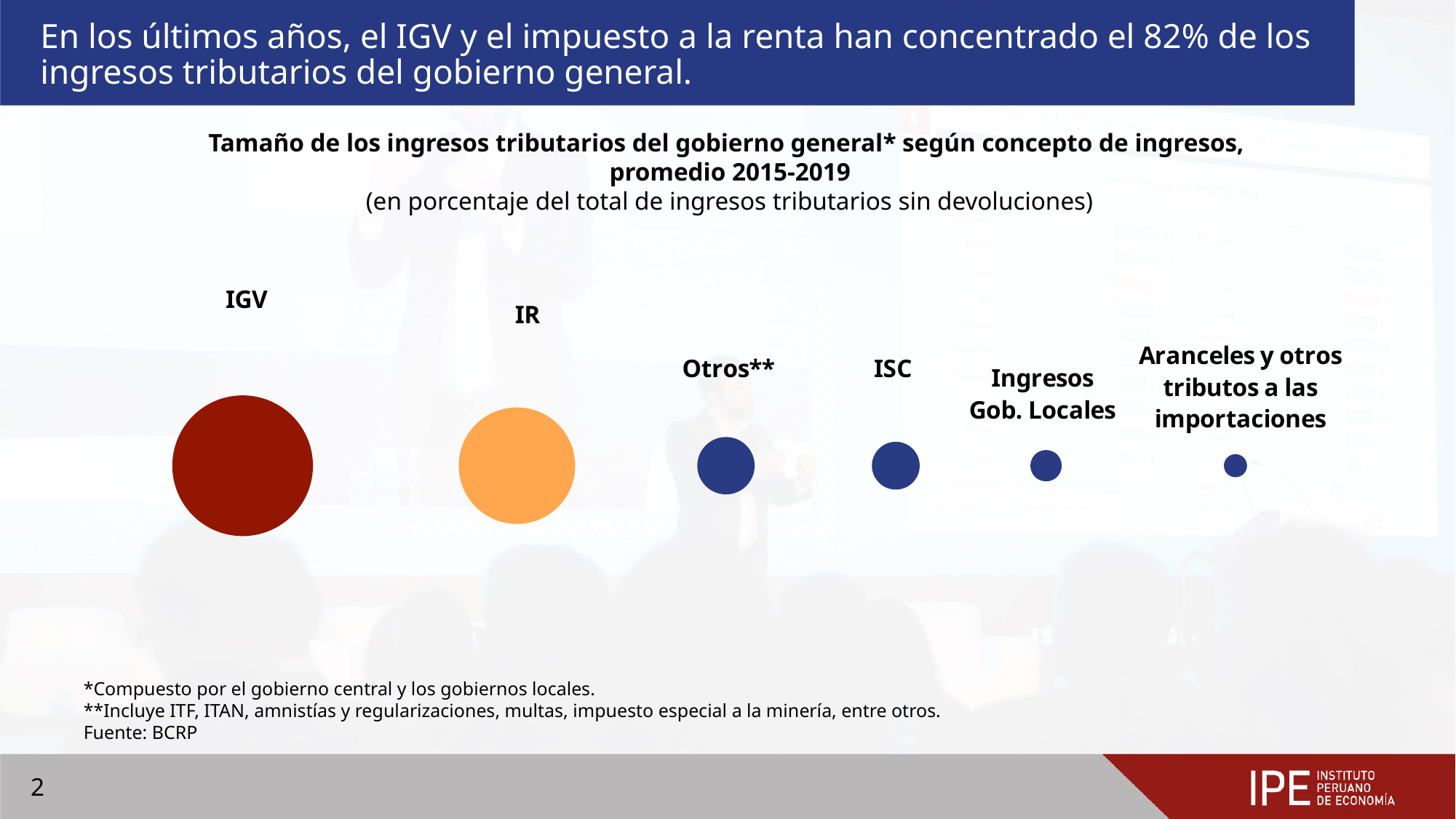
What kind of chart is shown on the slide? Bubble chart Which is larger in the chart, Ingresos Gob. Locales or Aranceles y otros tributos a las importaciones? Ingresos Gob. Locales What period does the chart title say the averages cover? 2015-2019 What colour is the IGV bubble? Dark red Which is larger in the chart, IGV or IR? IGV Which category has the smallest bubble in the chart? Aranceles y otros tributos a las importaciones Which is larger in the chart, IR or Otros**? IR Which category has the largest bubble in the chart? IGV Do the bubble sizes increase or decrease from left to right across the chart? Decrease How many revenue categories are shown in the chart? 6